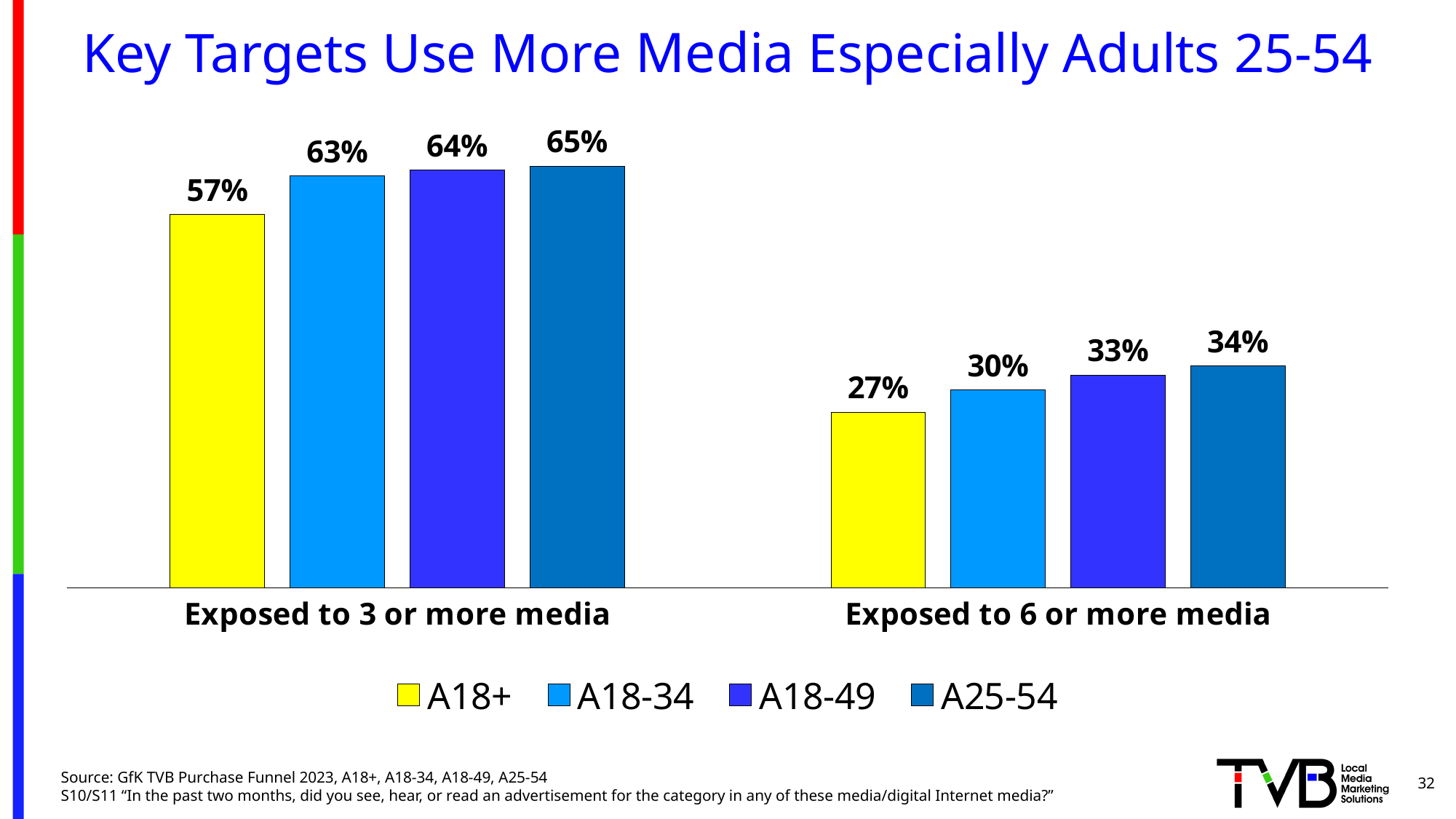
How many categories are shown on the x axis? 2 What is the value for A18-34 in the 'Exposed to 6 or more media' category? 30% What is the value for A18+ in the 'Exposed to 3 or more media' category? 57% What is the value for A18-49 in the 'Exposed to 3 or more media' category? 64% What kind of chart is shown on the slide? Bar chart How many series does the legend list? 4 Which series has the highest value in the 'Exposed to 6 or more media' category? A25-54 Which series has the lowest value in the 'Exposed to 3 or more media' category? A18+ What is the value for A25-54 in the 'Exposed to 6 or more media' category? 34% What is the difference between the A25-54 and A18+ values in the 'Exposed to 3 or more media' category? 8% What is the difference between the A18-49 and A18+ values in the 'Exposed to 6 or more media' category? 6% Which is larger: the A18-34 value for 'Exposed to 3 or more media' or the A18-34 value for 'Exposed to 6 or more media'? Exposed to 3 or more media